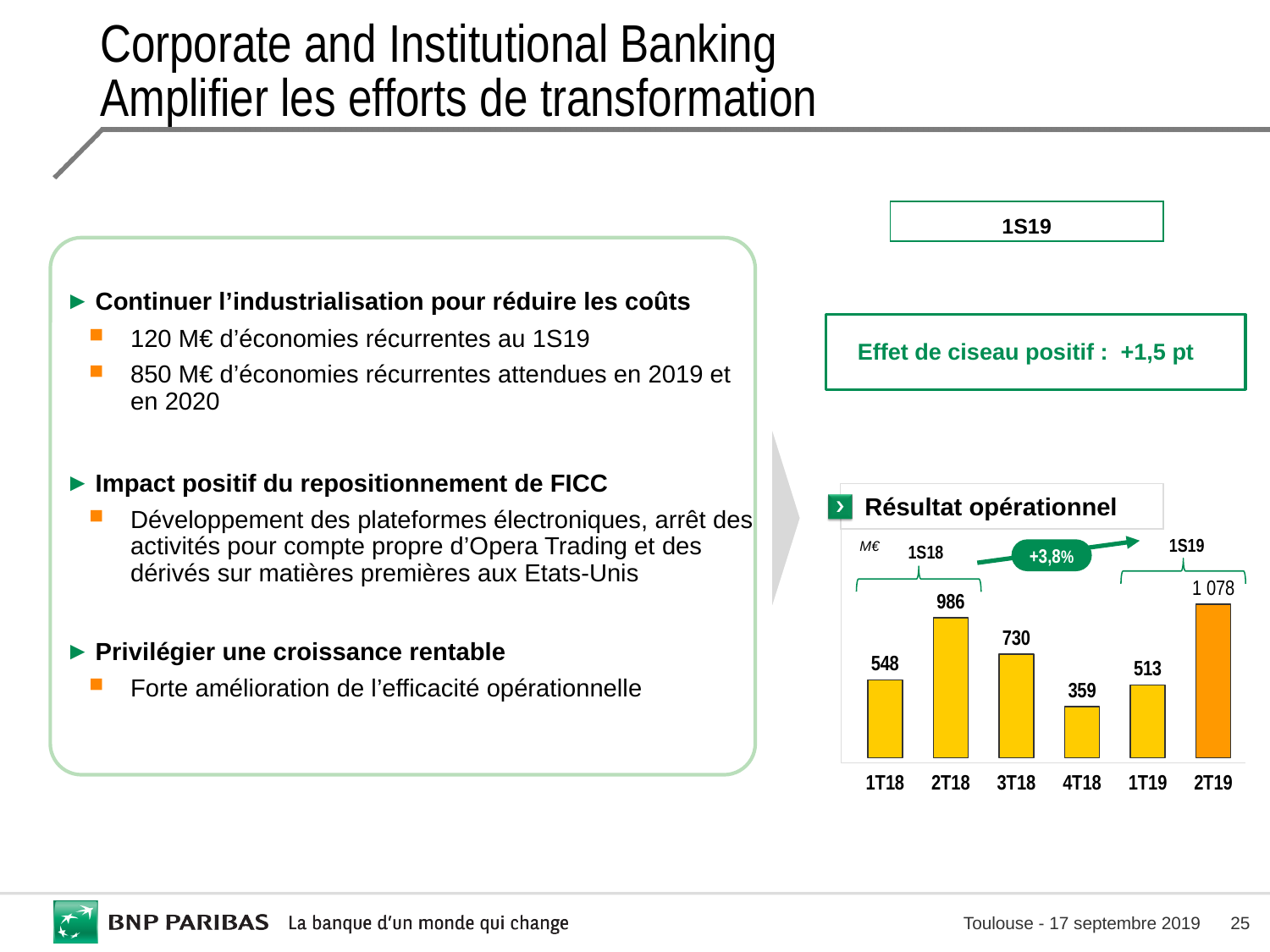
What is the value for 4T18 in the Résultat opérationnel chart? 359 How many quarters are shown in the Résultat opérationnel chart? 6 Which is larger in the Résultat opérationnel chart, the value for 3T18 or the value for 1T19? 3T18 What is the value for 1T18 in the Résultat opérationnel chart? 548 What is the unit shown in the Résultat opérationnel chart? M€ What is the difference between the values for 2T18 and 1T18 in the Résultat opérationnel chart? 438 What percentage change between 1S18 and 1S19 is shown in the Résultat opérationnel chart? +3,8% What is the value for 2T19 in the Résultat opérationnel chart? 1 078 What is the difference between the values for 2T19 and 1T19 in the Résultat opérationnel chart? 565 Which quarter has the lowest value in the Résultat opérationnel chart? 4T18 What kind of chart is the Résultat opérationnel chart? bar chart Which quarter has the highest value in the Résultat opérationnel chart? 2T19